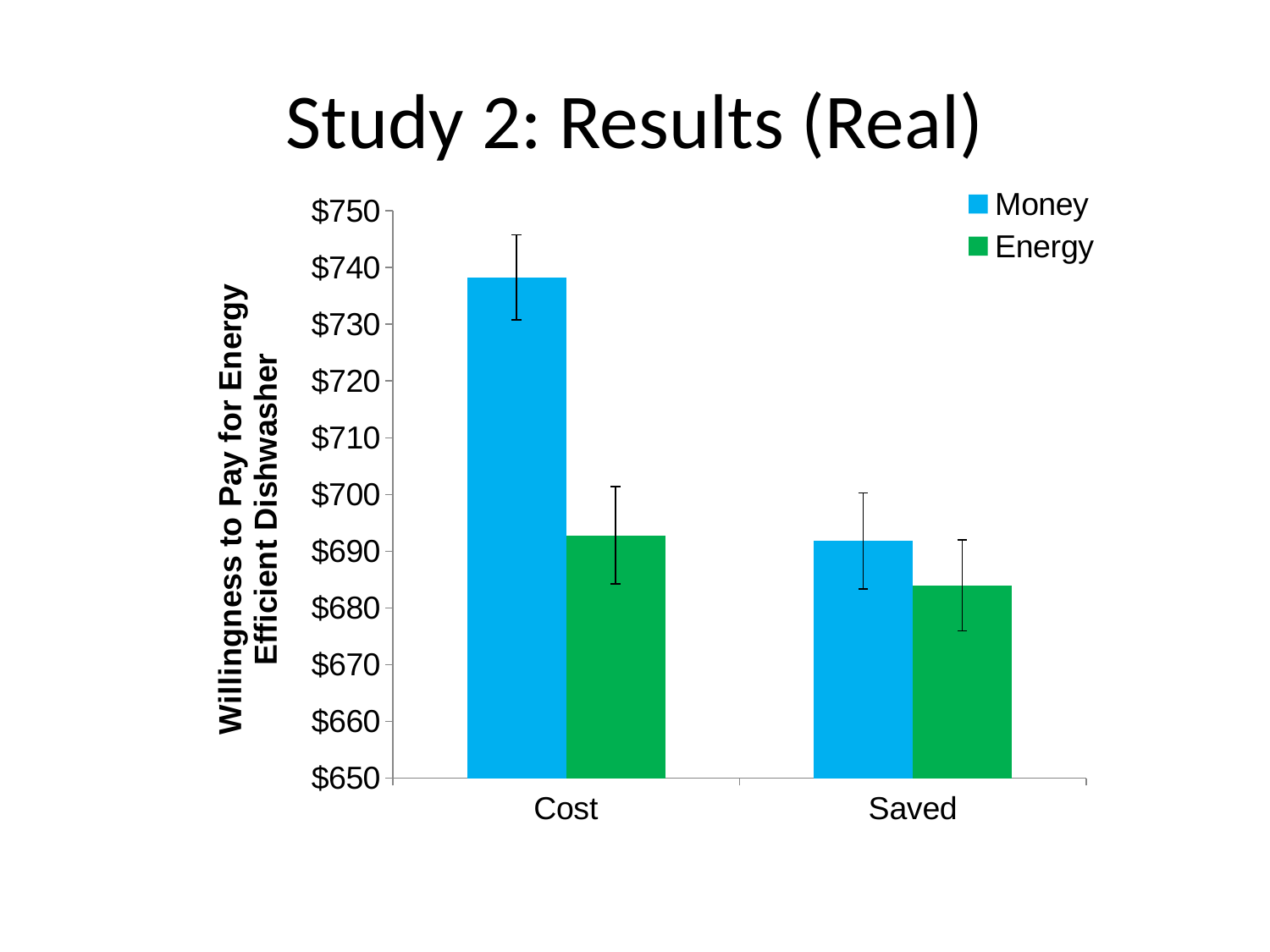
Which bar is the lowest in the chart? Energy for Saved In the Cost category, which is larger, the Money bar or the Energy bar? Money How many series does the legend list? 2 Which bar is the tallest in the chart? Money for Cost Is the Energy value for Cost greater or less than $700? less Is the Money value for Saved greater or less than $680? greater Is the Energy value for Saved greater or less than $690? less How many categories are shown on the x axis? 2 Which category has the highest Money bar? Cost What is the label on the vertical axis? Willingness to Pay for Energy Efficient Dishwasher What kind of chart is shown on the slide? bar chart